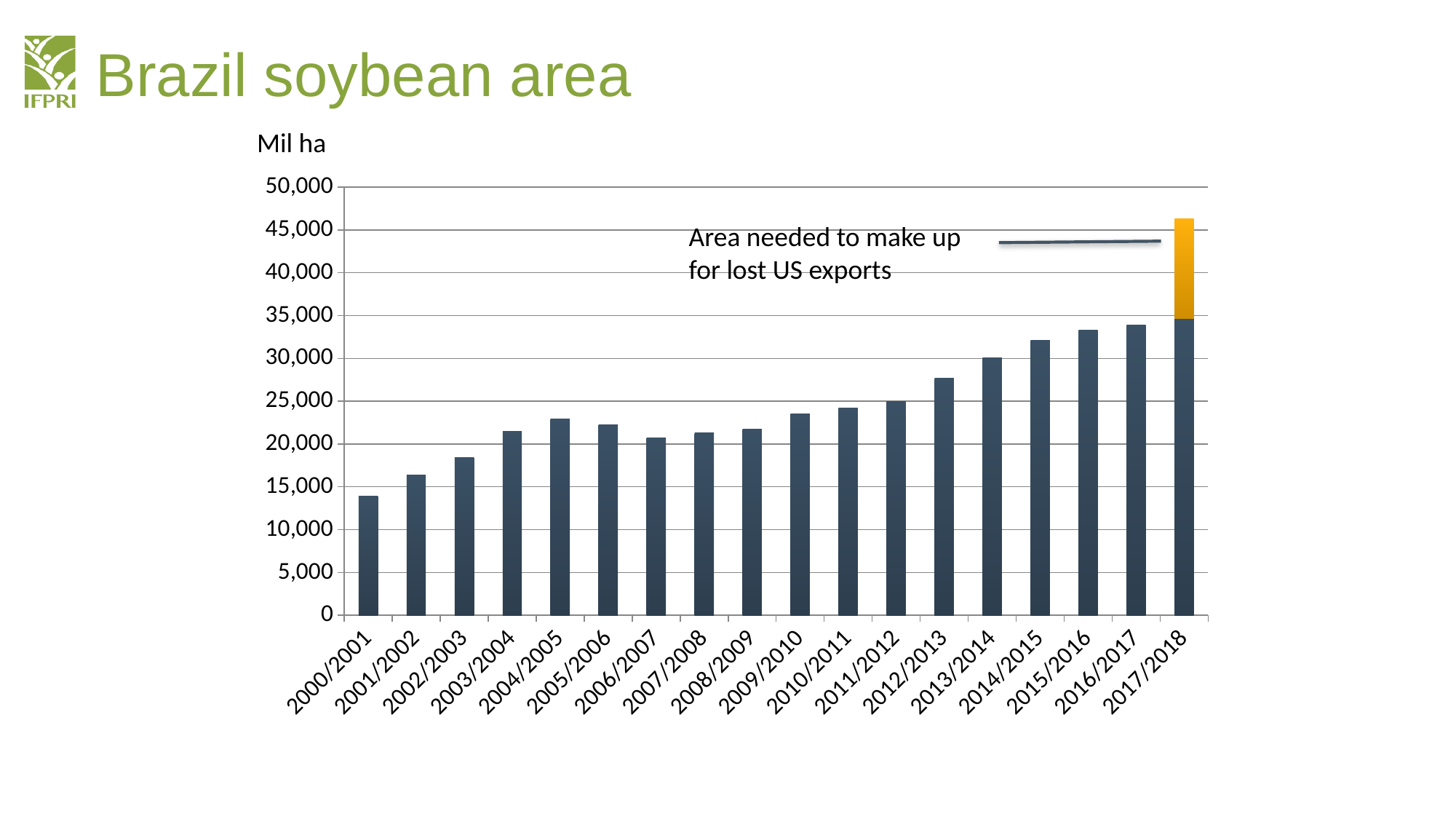
Which is larger, the soybean area in 2004/2005 or in 2006/2007? 2004/2005 What does the orange segment on top of the 2017/2018 bar represent? Area needed to make up for lost US exports What kind of chart is shown on the slide? bar chart What unit is shown on the y axis of the chart? Mil ha Do the values generally rise or fall from 2000/2001 to 2017/2018? rise Is the value for 2000/2001 greater or less than 15,000? less How many crop years are shown on the x axis of the chart? 18 Which crop year has the tallest bar in the chart? 2017/2018 Which crop year has the lowest Brazil soybean area? 2000/2001 Is the value for 2009/2010 greater or less than 25,000? less Is the value for 2014/2015 greater or less than 30,000? greater